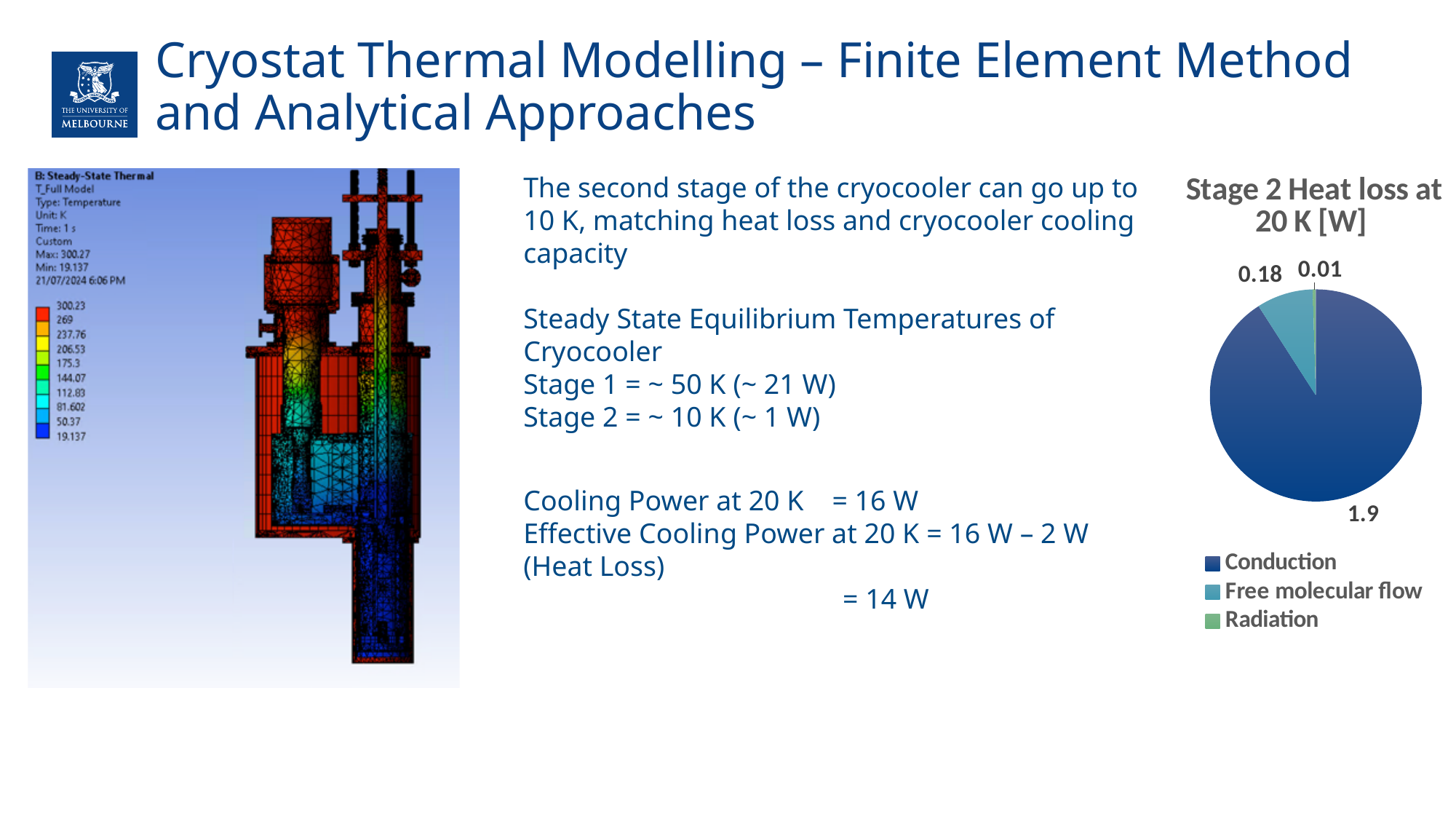
What is the heat loss value for Conduction in the pie chart? 1.9 Which category has the smallest slice in the pie chart? Radiation What is the heat loss value for Radiation in the pie chart? 0.01 What type of chart is shown on the slide? pie chart What is the difference between the Conduction and Free molecular flow values in the pie chart? 1.72 What is the title of the pie chart? Stage 2 Heat loss at 20 K [W] How many entries does the legend of the pie chart list? 3 How many slices does the pie chart have? 3 What is the total of all slices in the pie chart? 2.09 Which category has the largest slice in the pie chart? Conduction Which is larger in the pie chart, Free molecular flow or Radiation? Free molecular flow What is the heat loss value for Free molecular flow in the pie chart? 0.18